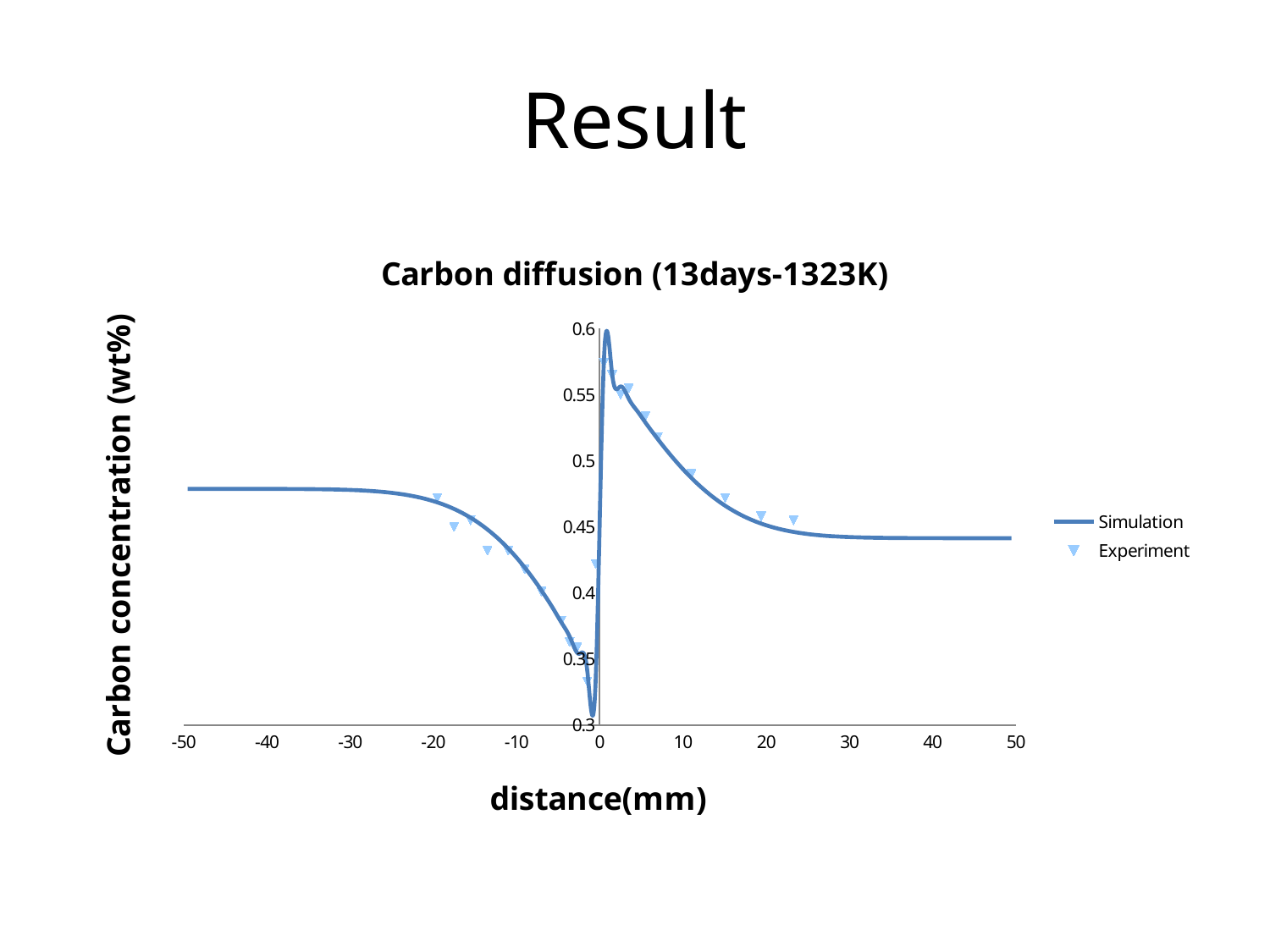
What is the title of the chart? Carbon diffusion (13days-1323K) What are the two series named in the legend? Simulation and Experiment Does the Simulation curve rise or fall as distance increases from 10 mm to 30 mm? fall Is the lowest point of the Simulation curve greater or less than 0.35? less Which is larger for the Simulation series: the value at -40 mm or the value at 40 mm? the value at -40 mm Is the Simulation value at a distance of 10 mm greater or less than 0.45? greater How many series does the chart legend list? 2 What kind of chart is shown on the slide? line chart Is the Simulation value at a distance of 40 mm greater or less than 0.45? less Does the Simulation curve rise or fall as distance increases from -20 mm to -5 mm? fall